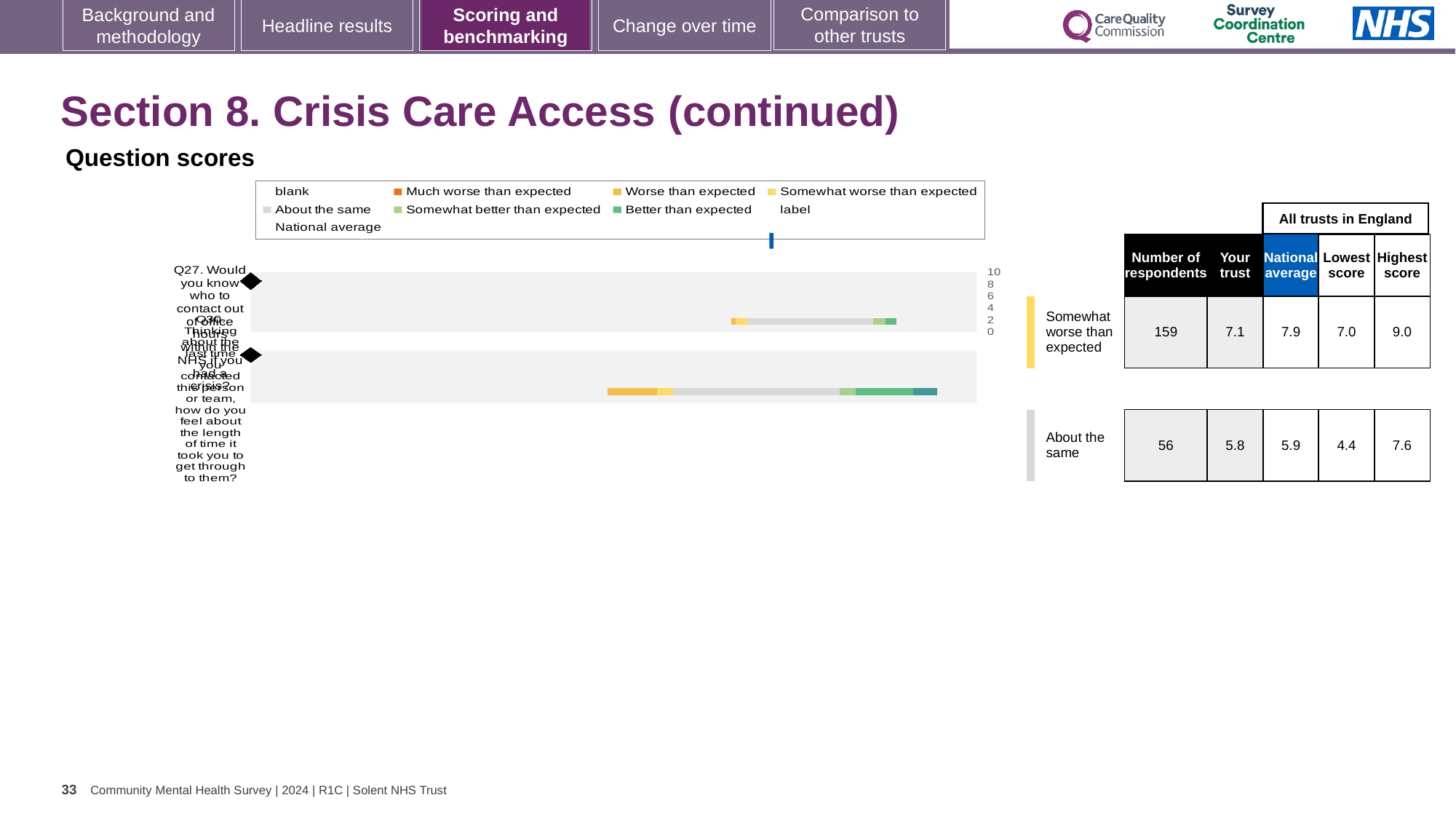
What is the difference between the highest score and the lowest score for Q30? 3.2 How many respondents are listed for Q27 in the table next to the chart? 159 How many questions are plotted in the question scores chart? 2 What is the 'Your trust' score for Q27? 7.1 What is the national average score for Q30? 5.9 What is the highest score among all trusts in England for Q27? 9.0 What kind of chart is used to show the question scores on this slide? bar chart What is the difference between the national average and the 'Your trust' score for Q27? 0.8 What benchmark category is shown for Q27 beside the table? Somewhat worse than expected Which question has the larger number of respondents, Q27 or Q30? Q27 For Q27, which is larger: the 'Your trust' score or the national average? National average What is the lowest score among all trusts in England for Q30? 4.4